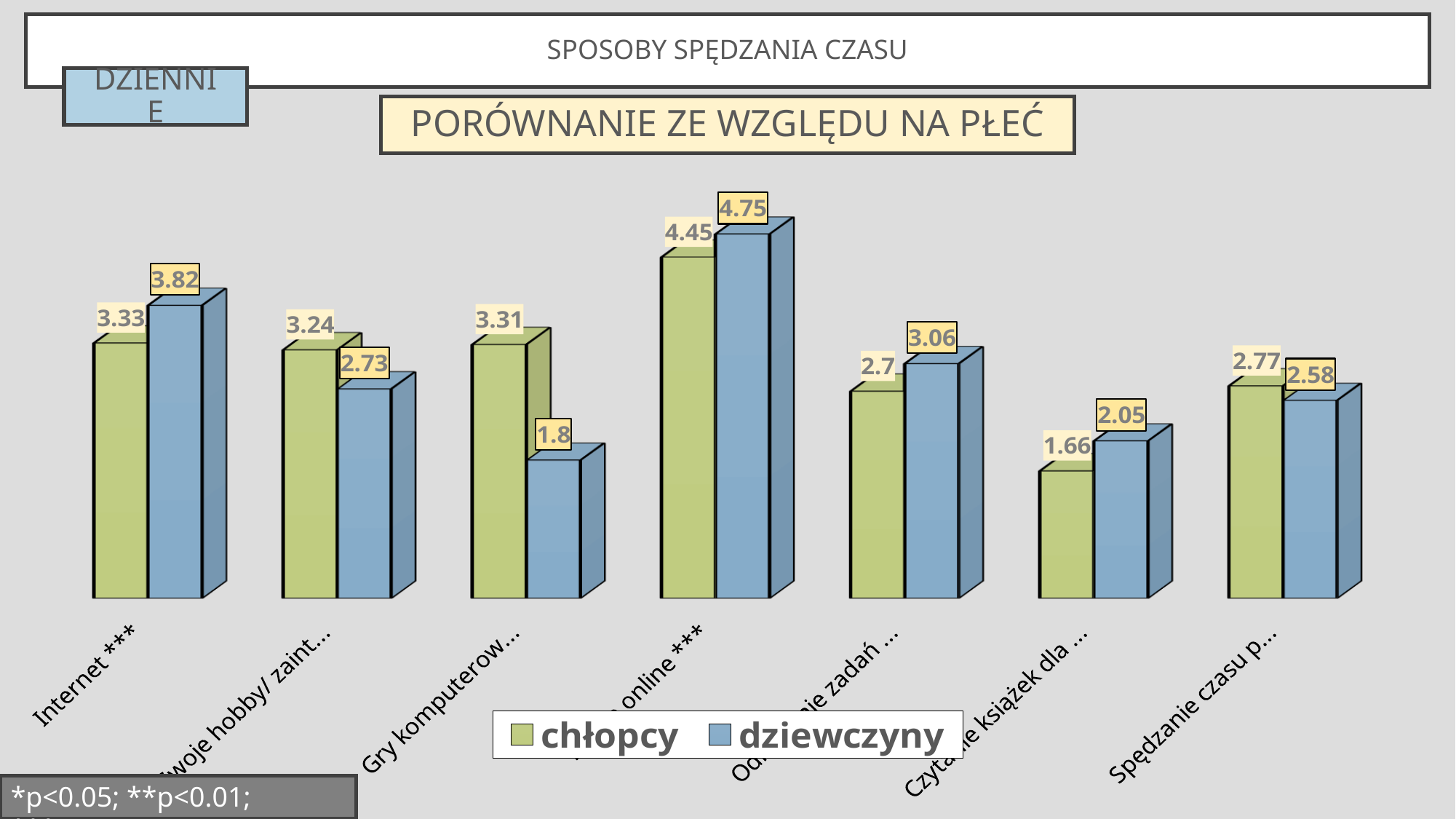
How many series does the legend list? 2 What is the value for chłopcy in the category "Internet ***"? 3.33 Which category has the highest value for dziewczyny? The fourth category from the left (label ending "online ***") What is the value for dziewczyny in the category whose label begins "Gry komputerow"? 1.8 In the category whose label begins "Gry komputerow", which series has the larger value, chłopcy or dziewczyny? chłopcy In the category whose label begins "Odrabianie zadań", which series has the larger value, chłopcy or dziewczyny? dziewczyny What type of chart is shown on the slide? Bar chart What is the value for dziewczyny in the category "Internet ***"? 3.82 What is the value for chłopcy in the category whose label begins "Czytanie książek"? 1.66 Which category has the lowest value for chłopcy? The category beginning "Czytanie książek" How many categories are shown on the x axis of the chart? 7 What is the difference between the dziewczyny and chłopcy values in the category "Internet ***"? 0.49